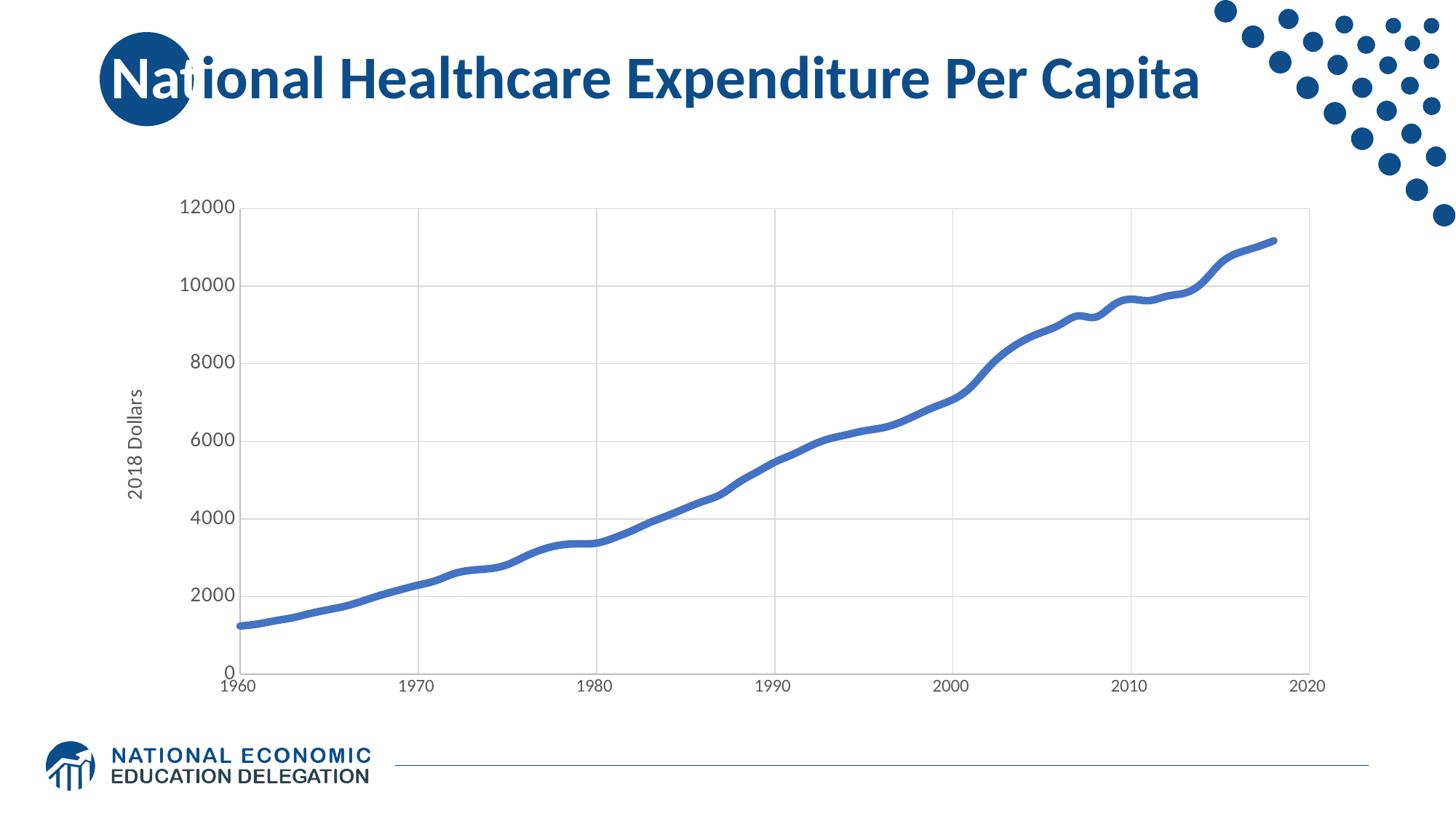
What kind of chart is shown on the slide? line chart Is the value for 1960 greater or less than 2000? less Is the value for 2000 greater or less than 6000? greater What is the title of the chart? National Healthcare Expenditure Per Capita What is the label on the vertical axis of the chart? 2018 Dollars Is the value for 2010 greater or less than 10000? less In which year shown on the x axis is the value lowest? 1960 Which of the two values is larger, the value for 1970 or the value for 2000? 2000 Do the values rise or fall from 1960 to 2018 along the x axis? rise